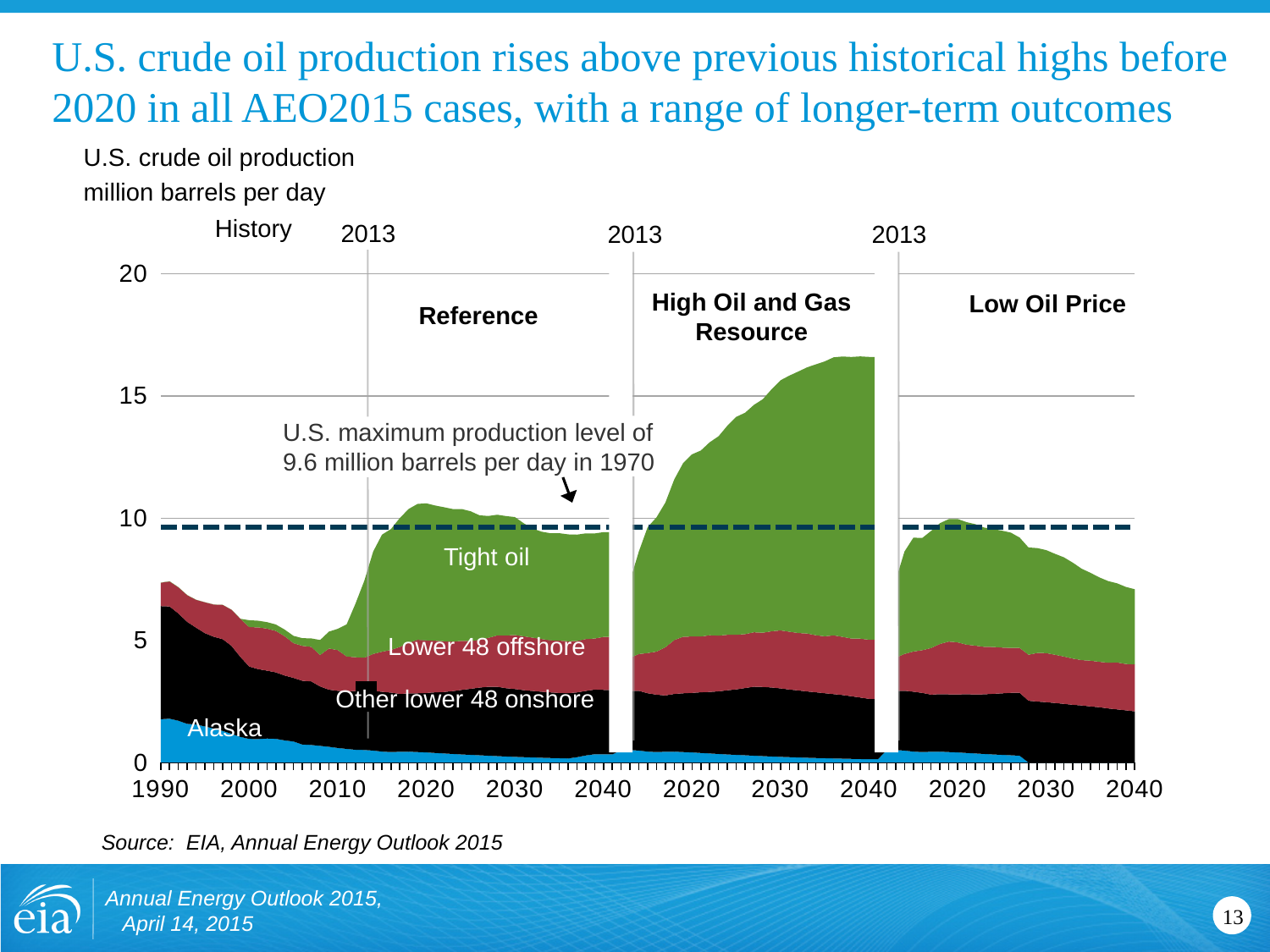
Is total production in the High Oil and Gas Resource case in 2040 greater or less than 15 million barrels per day? greater How many production components (series) are labeled in the chart? 4 In which year did the U.S. maximum production level of 9.6 million barrels per day occur? 1970 Which case shows the highest total crude oil production in 2040? High Oil and Gas Resource In the Low Oil Price case, does total production rise or fall between 2020 and 2040? fall What kind of chart is shown on the slide? Stacked area chart What unit is used on the chart's vertical axis? million barrels per day What was the U.S. maximum production level in 1970, according to the chart annotation? 9.6 million barrels per day Is total production in the Low Oil Price case in 2040 greater or less than 10 million barrels per day? less How many projection cases are shown in the chart? 3 Which case shows the lowest total crude oil production in 2040? Low Oil Price In the High Oil and Gas Resource case, does total production rise or fall between 2013 and 2040? rise